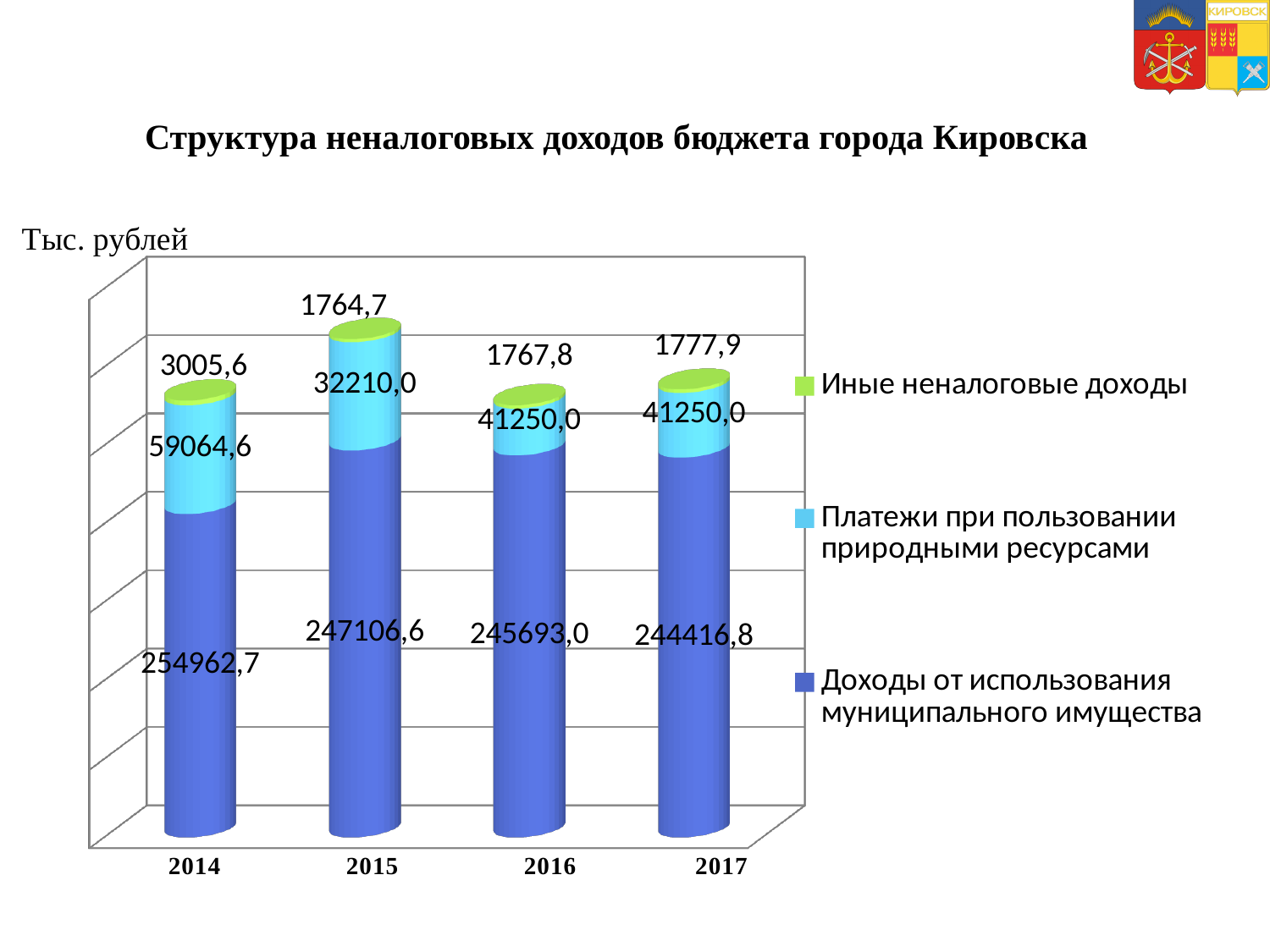
What is the value for "Доходы от использования муниципального имущества" in 2014? 254962,7 In which year is "Доходы от использования муниципального имущества" lowest? 2017 What is the value for "Платежи при пользовании природными ресурсами" in 2015? 32210,0 What is the value for "Иные неналоговые доходы" in 2017? 1777,9 What kind of chart is shown on the slide? Stacked bar chart How many series does the legend list? 3 Which is larger: "Платежи при пользовании природными ресурсами" in 2014 or in 2016? 2014 What is the difference between the 2014 and 2015 values for "Доходы от использования муниципального имущества"? 7856,1 How many years are shown on the x axis? 4 In which year is "Иные неналоговые доходы" highest? 2014 What is the total of the stacked bar for 2016? 288710,8 Do the values for "Доходы от использования муниципального имущества" rise or fall from 2014 to 2017? Fall